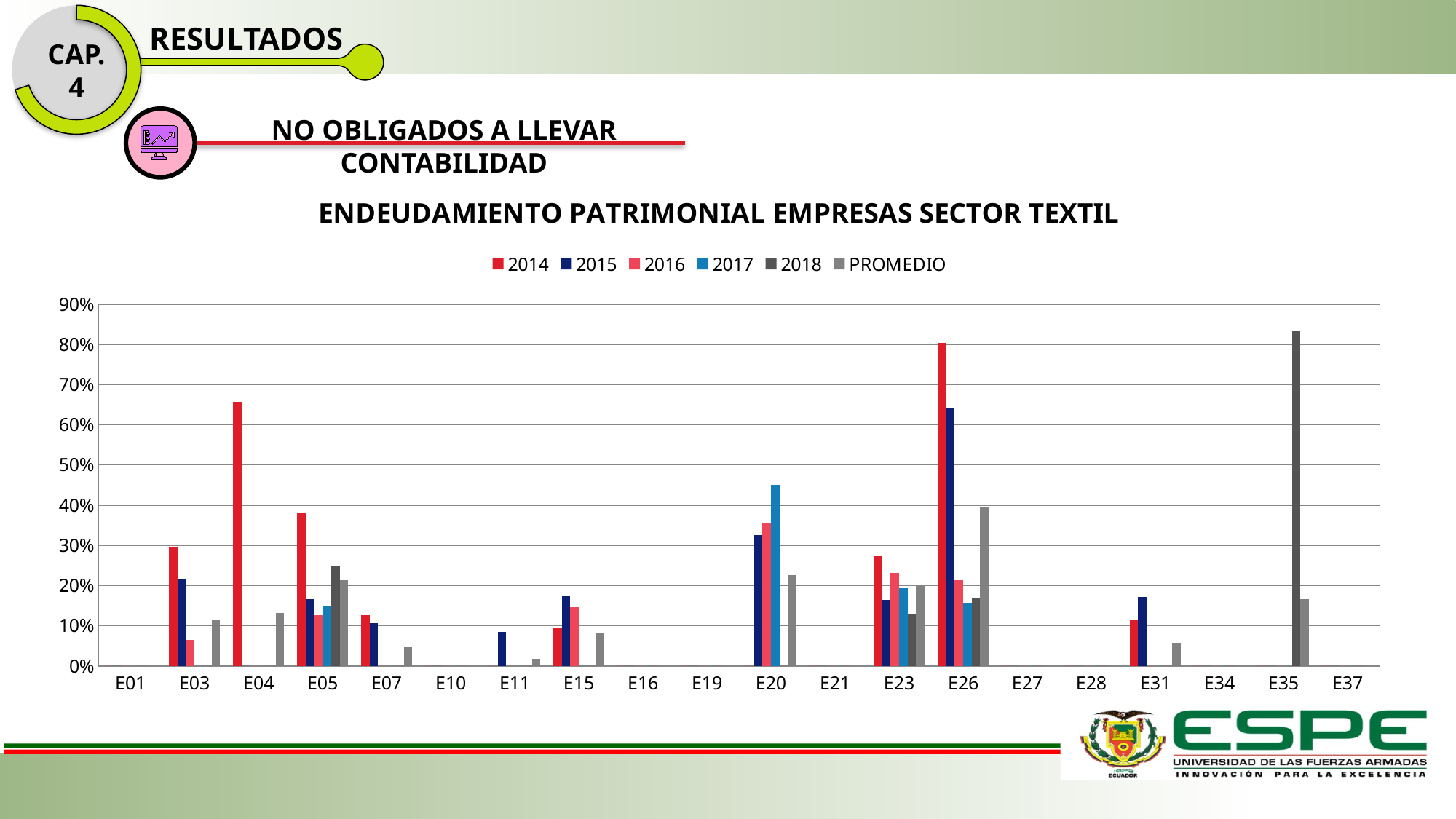
Is the 2015 value for E11 greater or less than 10%? less Which category has the highest value for the 2018 series? E35 How many series does the legend list? 6 What kind of chart is shown on the slide? bar chart Which category has the highest value for the 2014 series? E26 For E26, which is larger: the 2014 value or the 2015 value? 2014 Is the 2014 value for E04 greater or less than 60%? greater Is the 2017 value for E20 greater or less than 40%? greater Which category has the highest PROMEDIO value? E26 What is the title of the chart? ENDEUDAMIENTO PATRIMONIAL EMPRESAS SECTOR TEXTIL How many company categories are shown on the x axis? 20